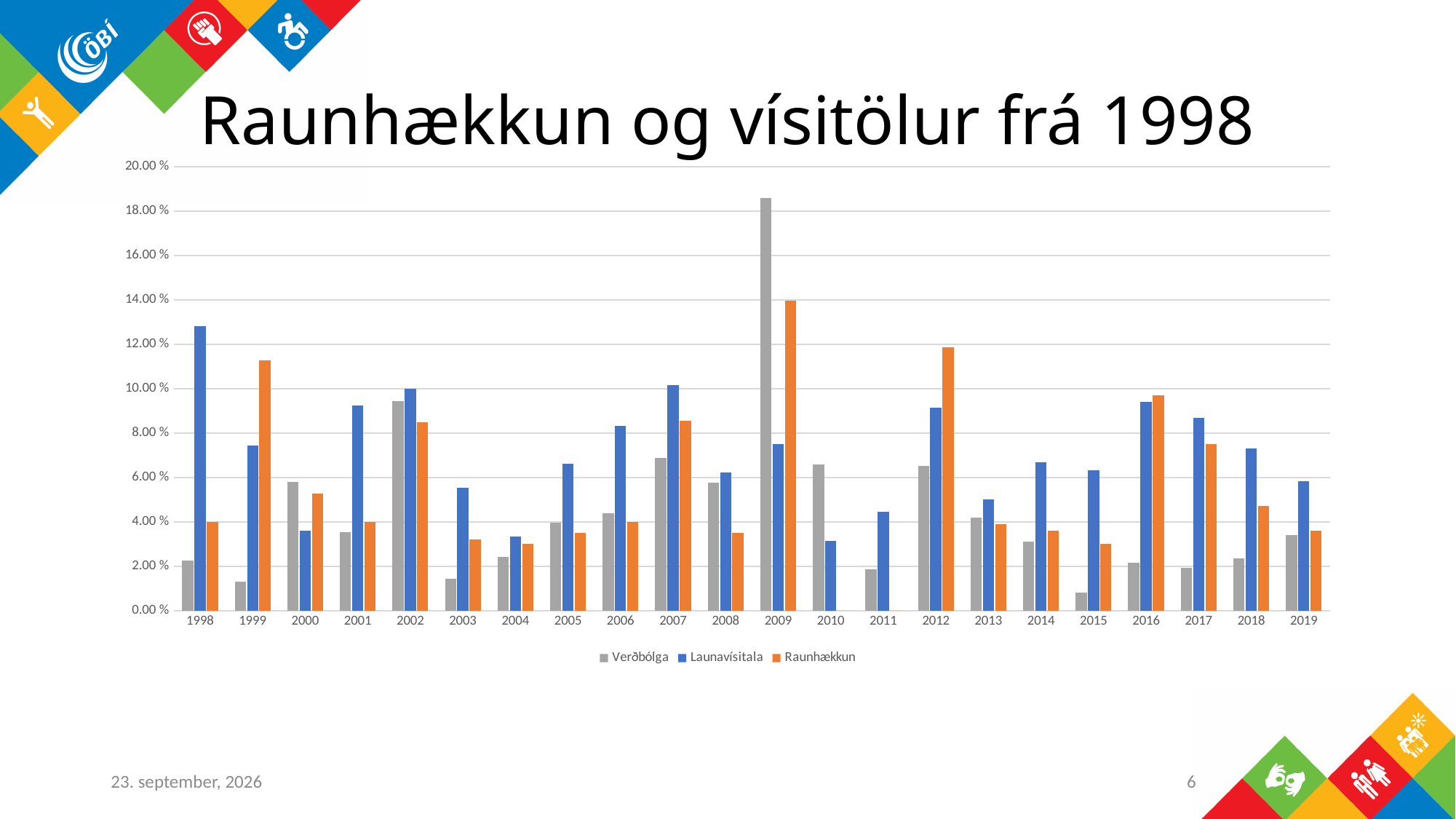
In which year is the Verðbólga value lowest? 2015 Is the Verðbólga value for 2015 greater or less than 2.00 %? less In which year is the Launavísitala value highest? 1998 How many series does the legend list? 3 Is the Verðbólga value for 2009 greater or less than 18.00 %? greater What kind of chart is shown on the slide? Bar chart What is the title of the chart? Raunhækkun og vísitölur frá 1998 Is the Launavísitala value for 1998 greater or less than 12.00 %? greater In 2009, which is larger: Verðbólga or Raunhækkun? Verðbólga How many years are shown along the x axis? 22 In which year is the Verðbólga value highest? 2009 In which year is the Raunhækkun value highest? 2009